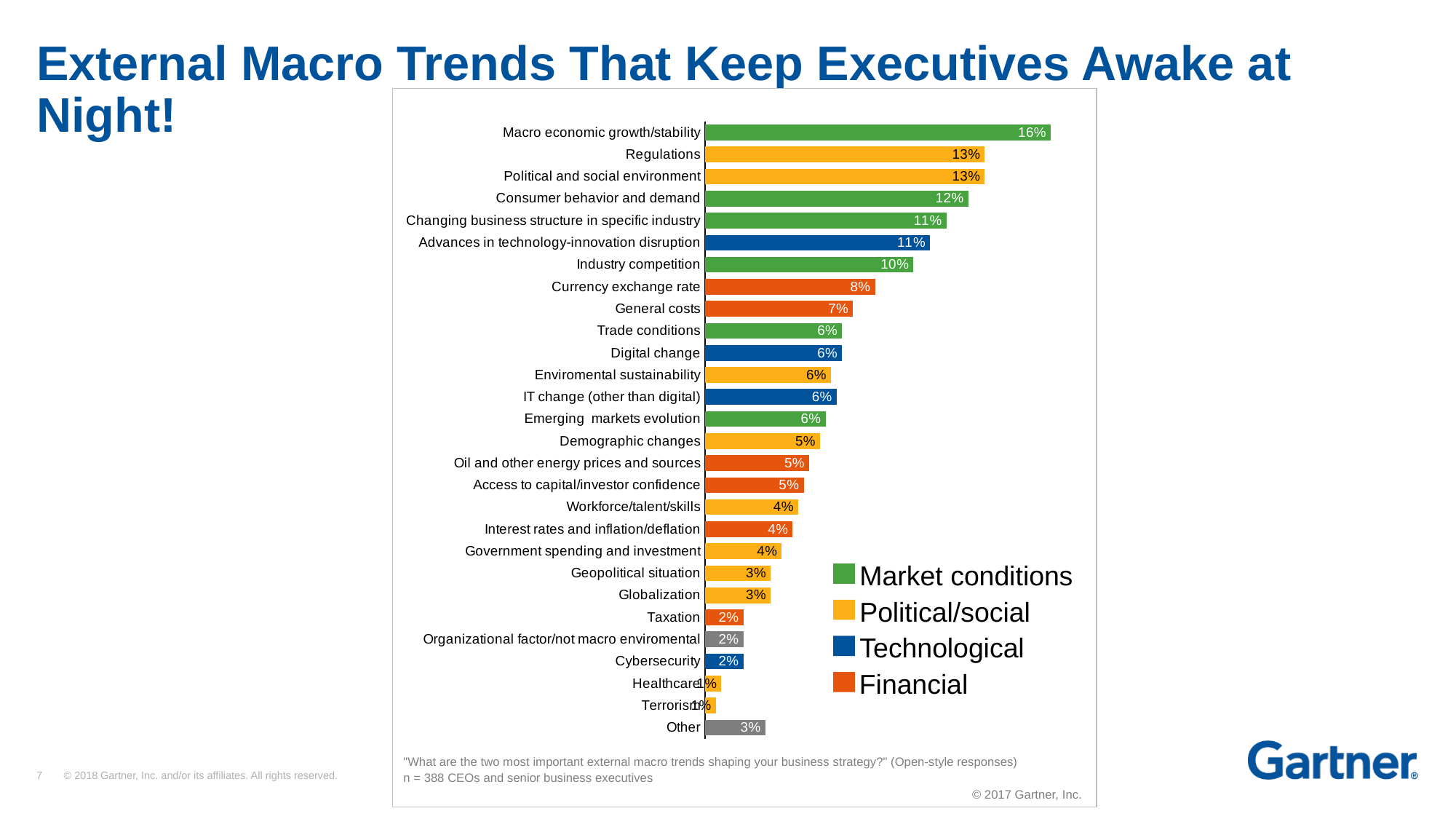
What is the value for Currency exchange rate? 8% What is the difference between the values for Regulations and Industry competition? 3% Which category has the highest value? Macro economic growth/stability Which is larger, the value for Advances in technology-innovation disruption or the value for Trade conditions? Advances in technology-innovation disruption What kind of chart is shown on the slide? Bar chart How many series does the legend list? 4 How many categories are plotted on the chart? 28 What is the value for Macro economic growth/stability? 16% What is the difference between the values for Macro economic growth/stability and Consumer behavior and demand? 4% Which legend entry is shown in blue? Technological What is the value for Cybersecurity? 2% Which is larger, the value for General costs or the value for Demographic changes? General costs